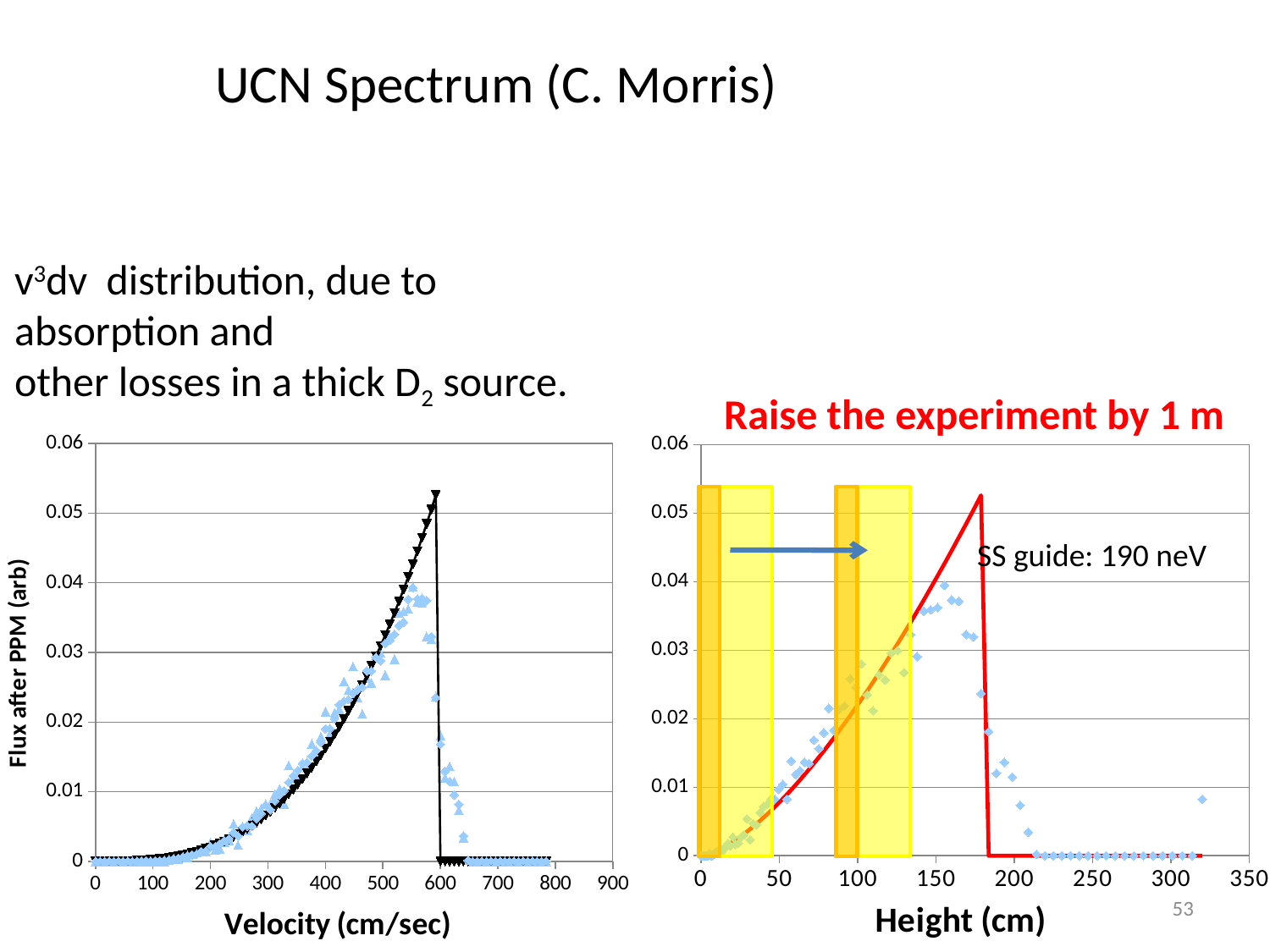
What is the x-axis label of the left chart? Velocity (cm/sec) What is the maximum value shown on the x axis of the left chart? 900 What is the maximum value shown on the y axis of the right chart? 0.06 In the left chart, is the value of the blue diamond series at a velocity of 700 cm/sec greater or less than 0.01? less In the left chart, does the black triangle series rise or fall as velocity increases from 0 to 500 cm/sec? rise In the right chart, is the value of the red line at a height of 250 cm greater or less than 0.01? less In the left chart, is the value of the black triangle series at a velocity of 400 cm/sec greater or less than 0.02? less